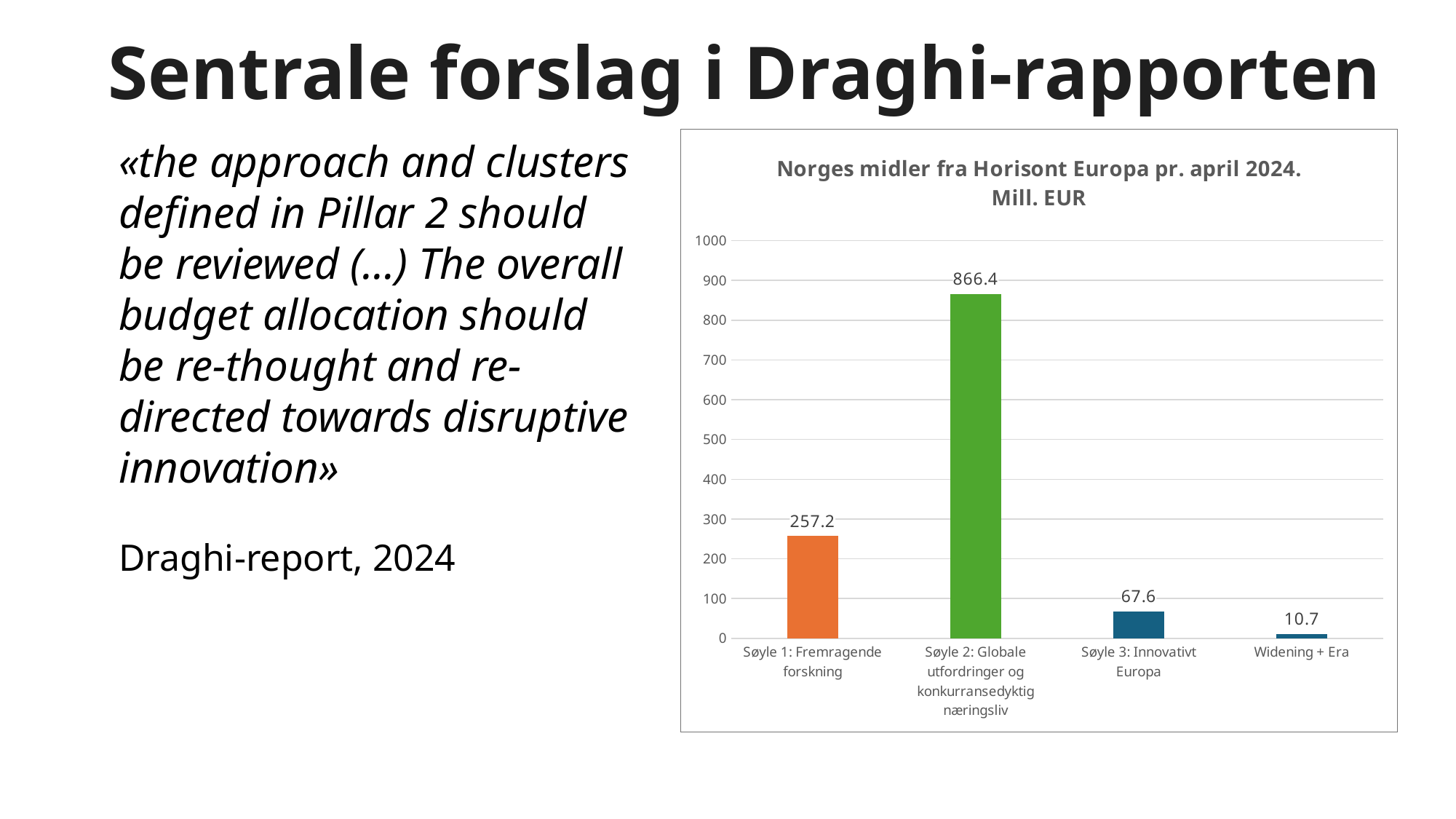
How many categories are shown in the chart? 4 Which category has the lowest value? Widening + Era What is the value for Søyle 2: Globale utfordringer og konkurransedyktig næringsliv? 866.4 What is the title of the chart? Norges midler fra Horisont Europa pr. april 2024. Mill. EUR Which is larger, the value for Søyle 1: Fremragende forskning or Søyle 3: Innovativt Europa? Søyle 1: Fremragende forskning What is the difference between the values for Søyle 2 and Søyle 1? 609.2 What is the difference between the values for Søyle 3: Innovativt Europa and Widening + Era? 56.9 What is the value for Søyle 3: Innovativt Europa? 67.6 What is the value for Widening + Era? 10.7 What is the value for Søyle 1: Fremragende forskning? 257.2 Which category has the highest value? Søyle 2: Globale utfordringer og konkurransedyktig næringsliv What kind of chart is shown on the slide? Bar chart